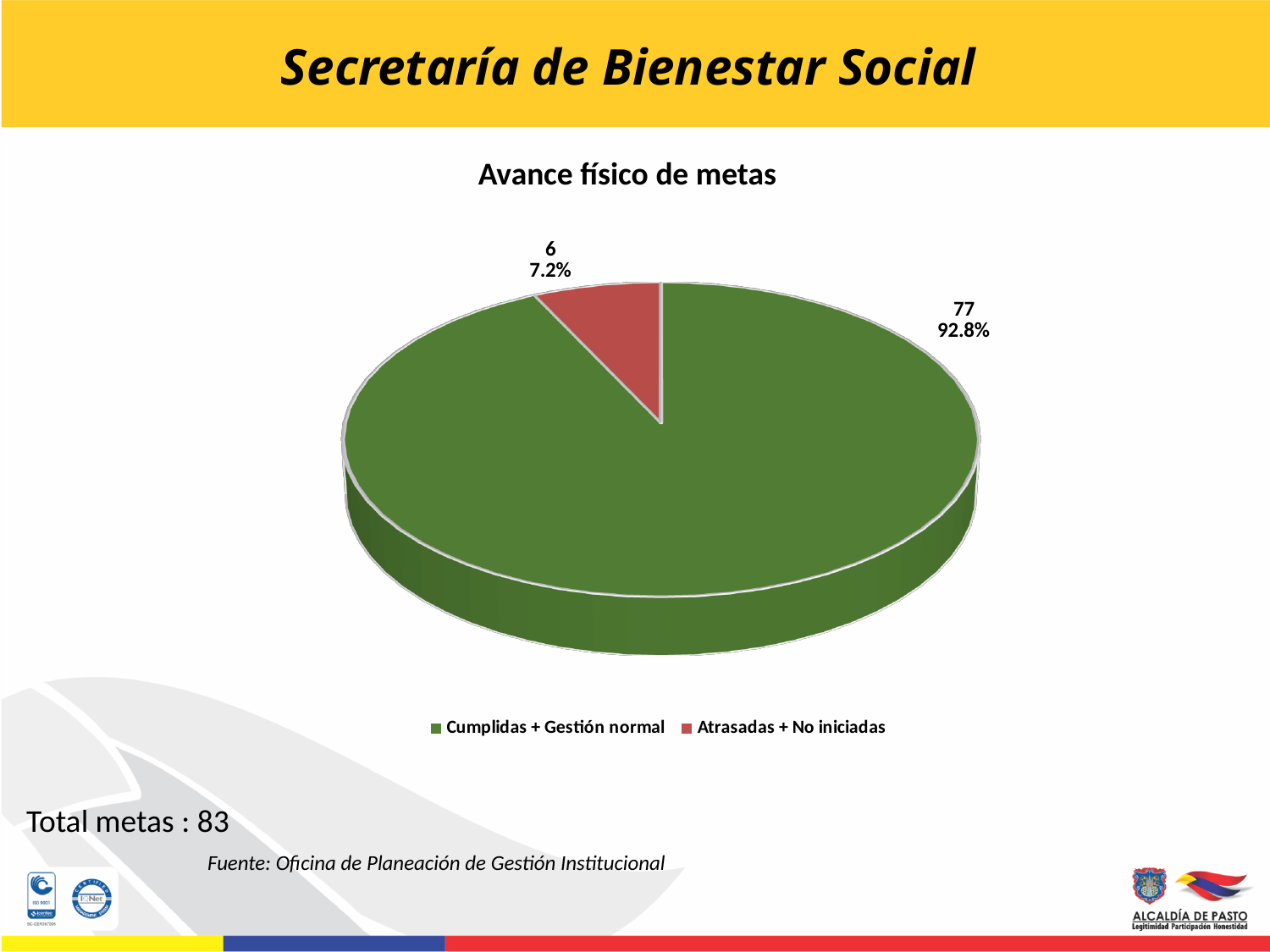
What share of the pie does Atrasadas + No iniciadas represent? 7.2% What is the difference between the values for Cumplidas + Gestión normal and Atrasadas + No iniciadas? 71 What is the title of the chart? Avance físico de metas Which category has the largest slice? Cumplidas + Gestión normal What is the value for Atrasadas + No iniciadas? 6 How many series does the legend list? 2 How many slices does the pie chart have? 2 What colour is the slice for Atrasadas + No iniciadas? Red What type of chart is shown on the slide? Pie chart What share of the pie does Cumplidas + Gestión normal represent? 92.8% What is the value for Cumplidas + Gestión normal? 77 Which category has the smallest slice? Atrasadas + No iniciadas